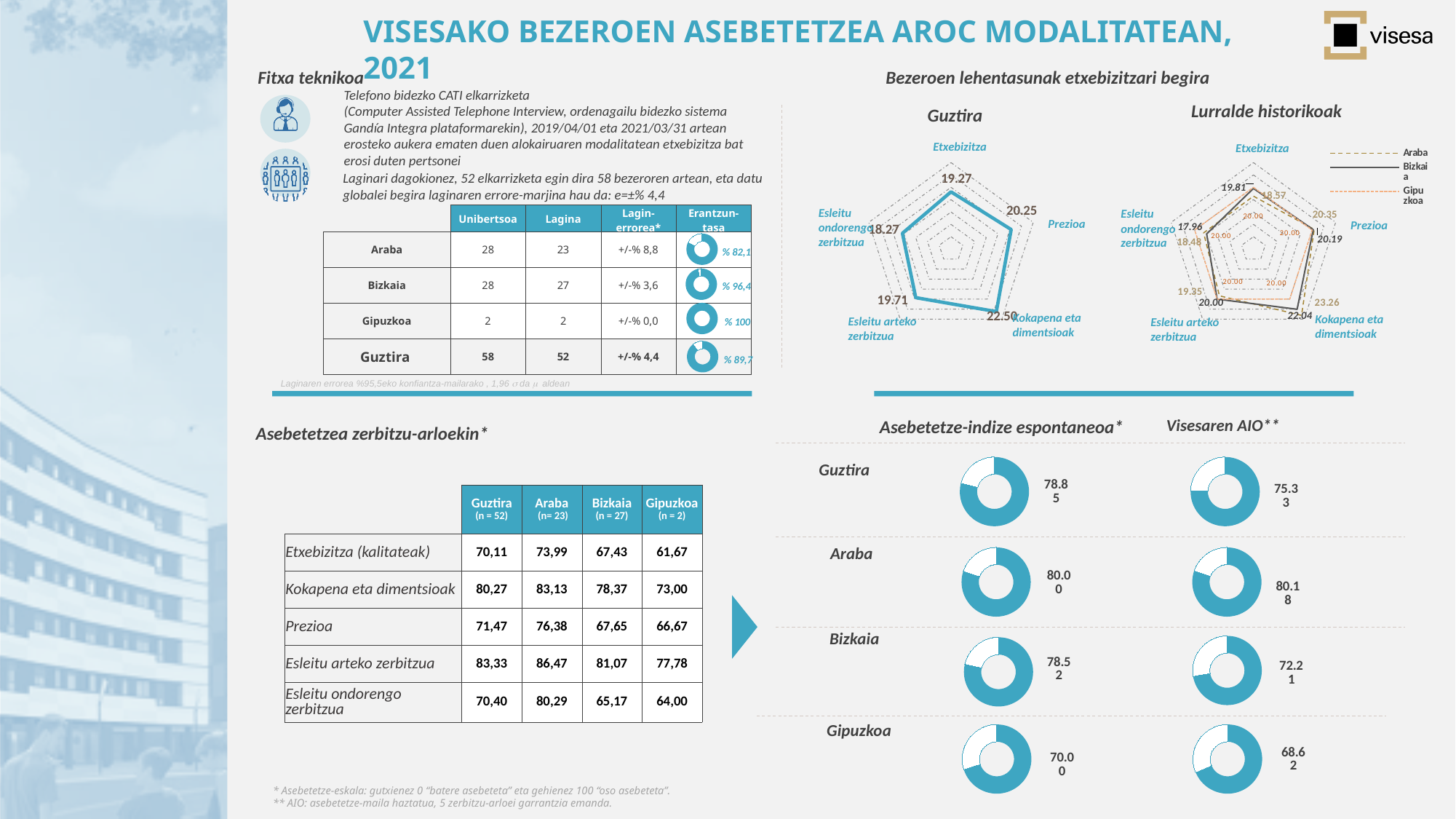
In the 'Guztira' radar chart, which category has the highest value? Kokapena eta dimentsioak In the 'Guztira' radar chart, what is the value for Prezioa? 20.25 In the 'Visesaren AIO' donut charts, what is the value for Araba? 80.18 In the 'Guztira' radar chart, what is the difference between the values for Kokapena eta dimentsioak and Etxebizitza? 3.23 How many categories (axes) does the 'Guztira' radar chart have? 5 In the 'Guztira' radar chart, which category has the lowest value? Esleitu ondorengo zerbitzua For Guztira, which is larger: the 'Asebetetze-indize espontaneoa' value or the 'Visesaren AIO' value? Asebetetze-indize espontaneoa (78.85) In the 'Asebetetze-indize espontaneoa' donut charts, what is the value for Gipuzkoa? 70.00 How many series does the legend of the 'Lurralde historikoak' radar chart list? 3 What are the legend entries of the 'Lurralde historikoak' radar chart? Araba, Bizkaia, Gipuzkoa What kind of chart is the 'Guztira' chart under 'Bezeroen lehentasunak etxebizitzari begira'? radar chart In the 'Guztira' radar chart, what is the value for Kokapena eta dimentsioak? 22.50